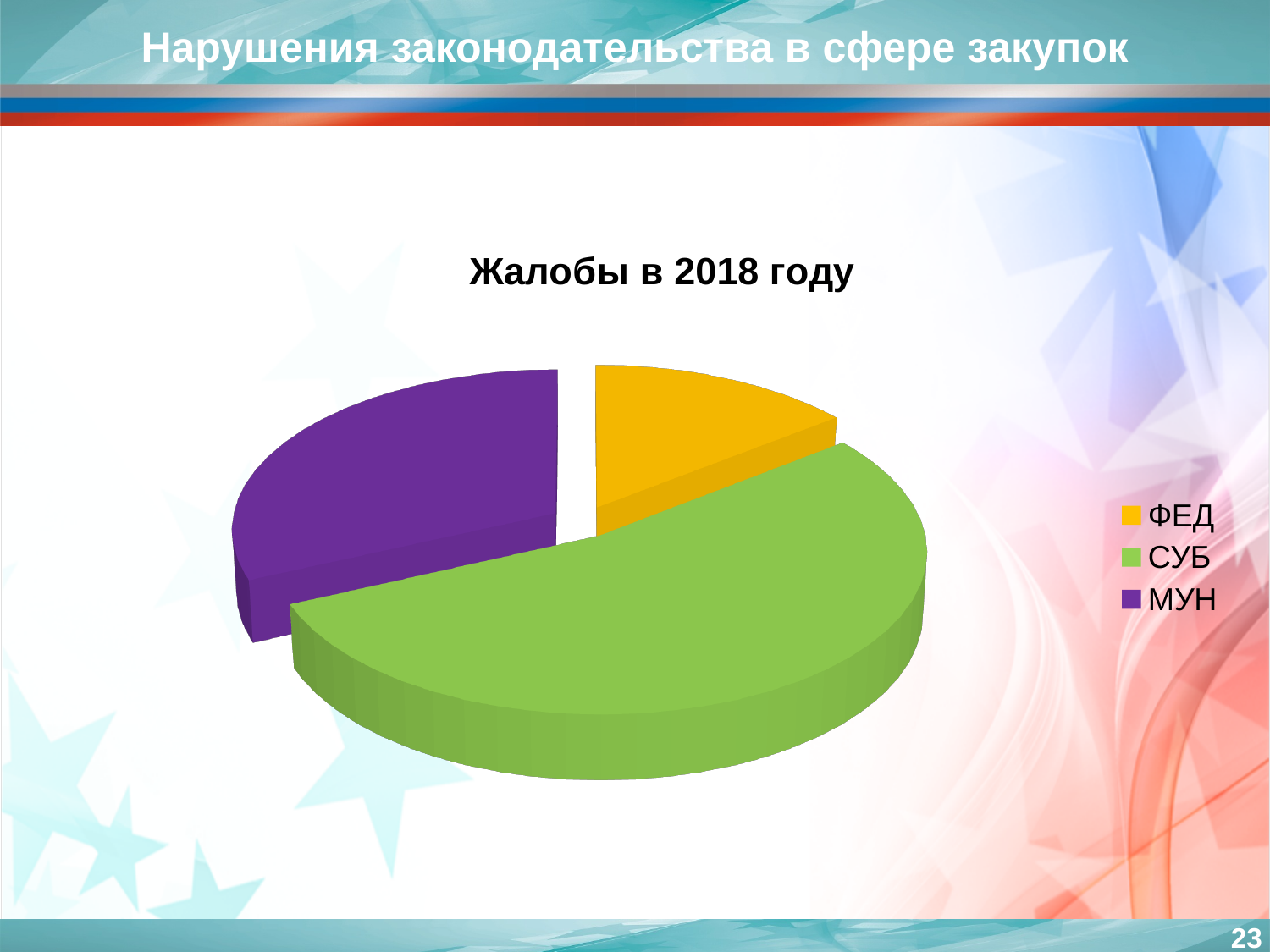
Which category has the largest slice of the pie? СУБ What kind of chart is shown on the slide? Pie chart Which category is shown in purple? МУН How many entries does the legend list? 3 What is the title of the chart? Жалобы в 2018 году Which category has the smallest slice of the pie? ФЕД What colour is the СУБ slice? Green How many slices does the pie chart have? 3 Which slice is larger, ФЕД or МУН? МУН Which slice is larger, СУБ or МУН? СУБ